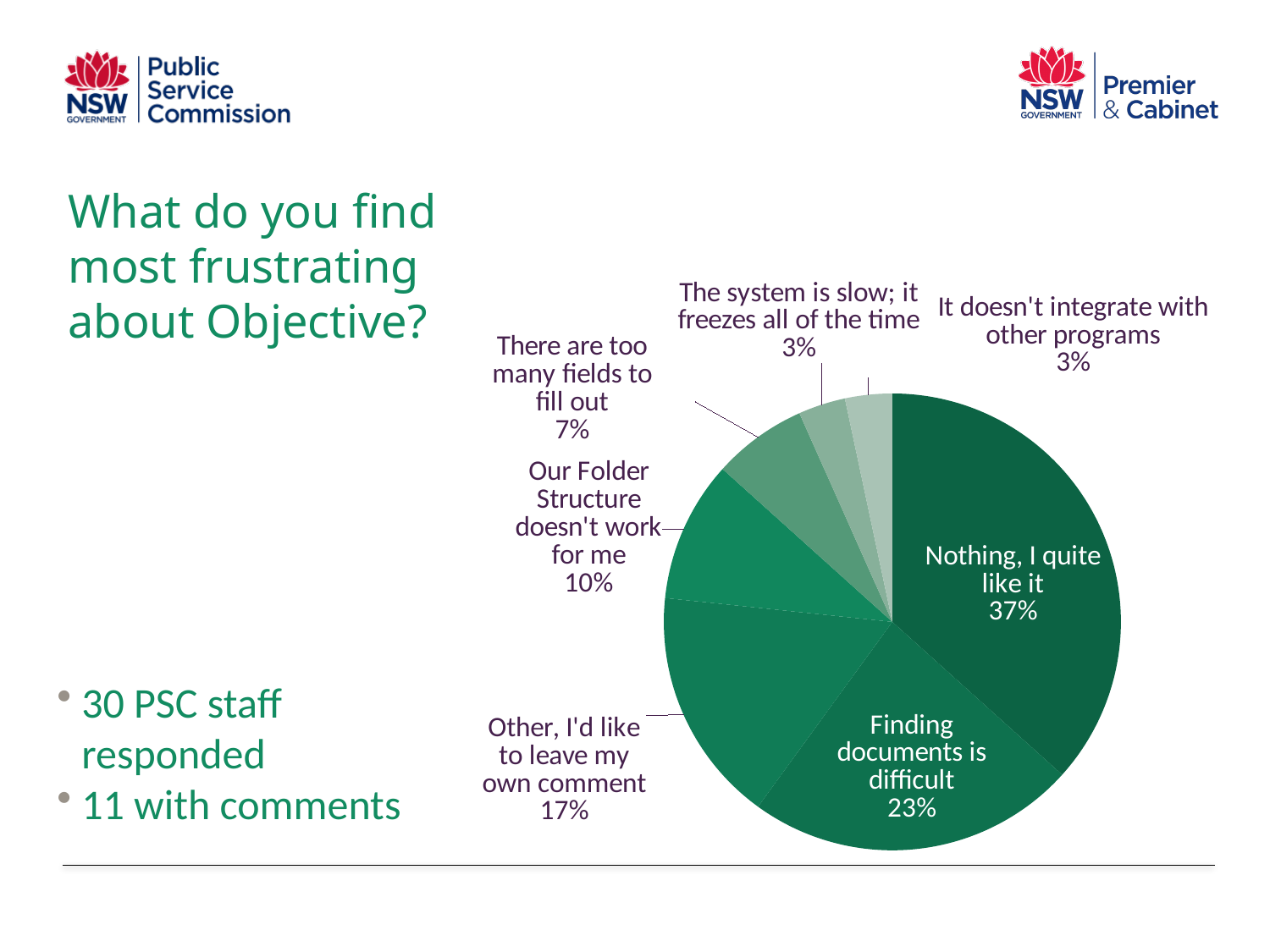
What is the difference in percentage points between "Nothing, I quite like it" and "Finding documents is difficult"? 14 What question does the slide title say the chart is about? What do you find most frustrating about Objective? What share of the pie is labelled "Finding documents is difficult"? 23% What share of the pie is labelled "The system is slow; it freezes all of the time"? 3% How many slices does the pie chart have? 7 What share of the pie is labelled "Our Folder Structure doesn't work for me"? 10% Which category has the largest slice of the pie? Nothing, I quite like it What kind of chart is shown on the slide? Pie chart Which is larger: the slice for "Our Folder Structure doesn't work for me" or the slice for "There are too many fields to fill out"? Our Folder Structure doesn't work for me